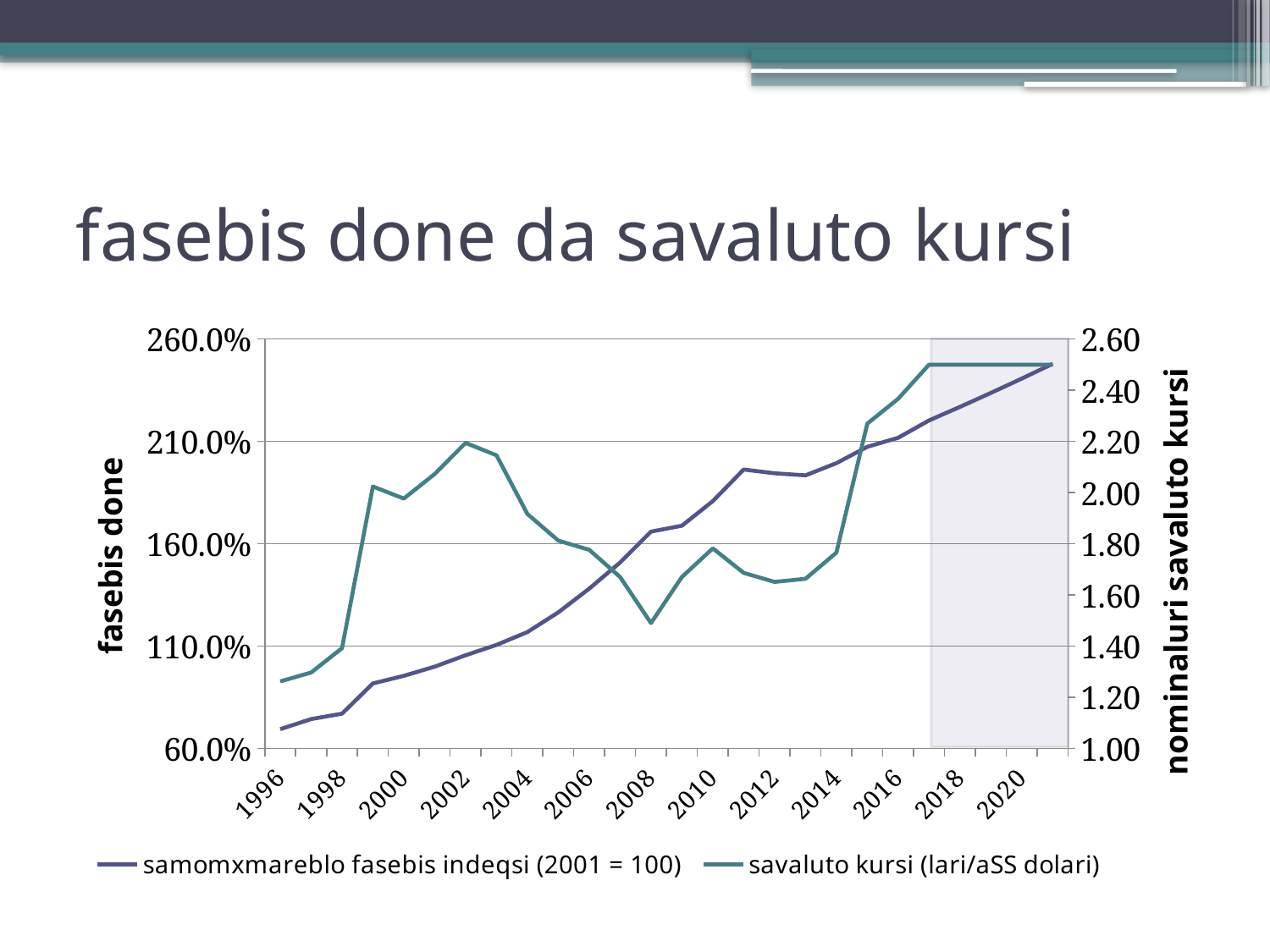
What kind of chart is shown on the slide? line chart Is the value of savaluto kursi (lari/aSS dolari) in 2018 greater or less than 2.40? greater Does the savaluto kursi (lari/aSS dolari) series rise or fall between 2002 and 2008? fall How many series does the legend list? 2 Is the value of samomxmareblo fasebis indeqsi (2001 = 100) in 2012 greater or less than 160.0%? greater Is the value of samomxmareblo fasebis indeqsi (2001 = 100) in 2020 greater or less than 210.0%? greater In which year is the savaluto kursi (lari/aSS dolari) series at its lowest? 1996 Does the samomxmareblo fasebis indeqsi (2001 = 100) series generally rise or fall from 1996 to 2020? rise What is the title of the right-hand vertical axis? nominaluri savaluto kursi